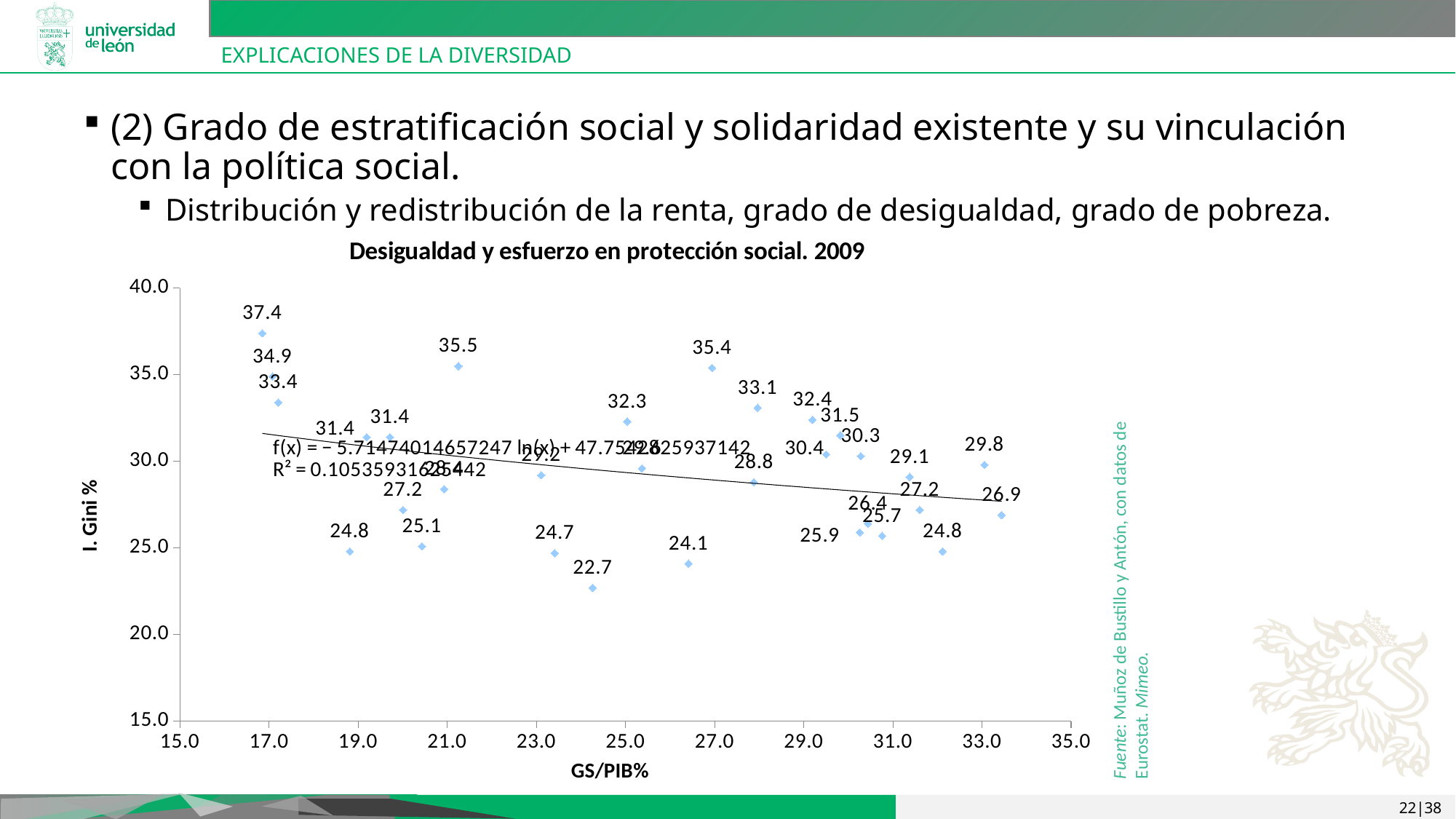
Is the lowest Gini value on the chart greater or less than 25.0? less What kind of chart is shown on the slide? scatter chart What is the title of the chart? Desigualdad y esfuerzo en protección social. 2009 What is the label of the x axis of the chart? GS/PIB% Is the Gini value of the rightmost point on the chart (26.9) greater or less than 30.0? less Which is larger, the highest Gini value on the chart (37.4) or the value 35.5 labelled near GS/PIB 21? 37.4 Does the trend line in the chart rise or fall as GS/PIB% increases? fall What is the difference between the highest and lowest Gini values labelled on the chart? 14.7 What is the lowest Gini value labelled on the chart? 22.7 Is the highest Gini value on the chart greater or less than 35.0? greater What is the highest Gini value labelled on the chart? 37.4